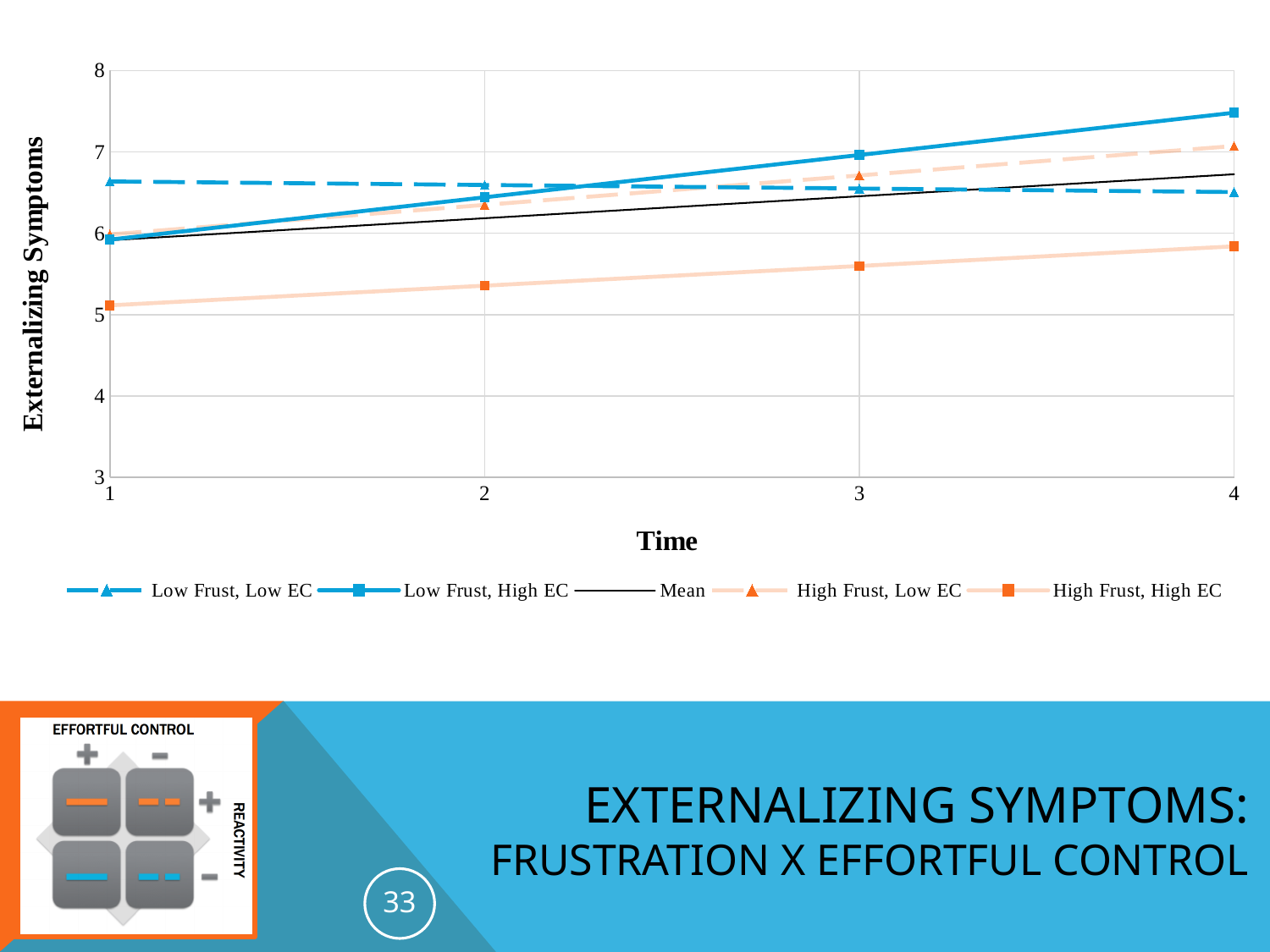
Is the value for High Frust, High EC at Time 1 greater or less than 6? less How many series does the legend list? 5 Is the value for High Frust, High EC at Time 4 greater or less than 6? less At Time 1, which is larger: Low Frust, Low EC or High Frust, High EC? Low Frust, Low EC Is the value for Low Frust, High EC at Time 4 greater or less than 7? greater Do the values for Low Frust, Low EC rise or fall from Time 1 to Time 4? fall What kind of chart is shown on the slide? line chart Which series has the lowest value at Time 4? High Frust, High EC Which series has the highest value at Time 4? Low Frust, High EC How many time points are plotted along the x axis? 4 Do the values for High Frust, High EC rise or fall from Time 1 to Time 4? rise